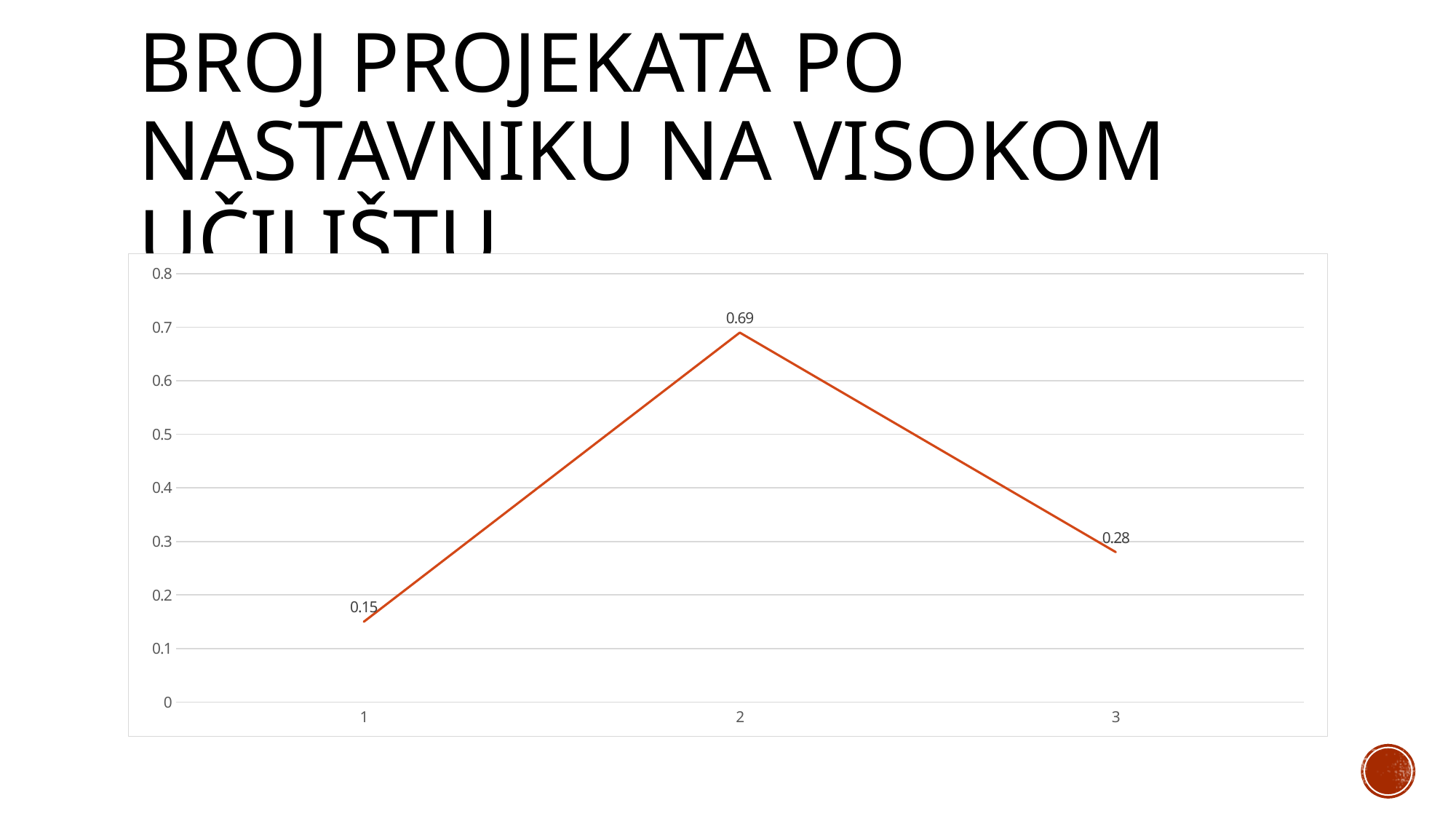
What is the value at category 3? 0.28 What is the difference between the values at category 2 and category 1? 0.54 Which category has the highest value? 2 What kind of chart is shown on the slide? line chart Is the value at category 2 greater or less than 0.6? greater Does the line rise or fall from category 2 to category 3? fall Which category has the lowest value? 1 What is the value at category 1? 0.15 Which is larger, the value at category 3 or the value at category 1? category 3 What is the value at category 2? 0.69 What is the difference between the values at category 2 and category 3? 0.41 How many data points are plotted on the chart? 3